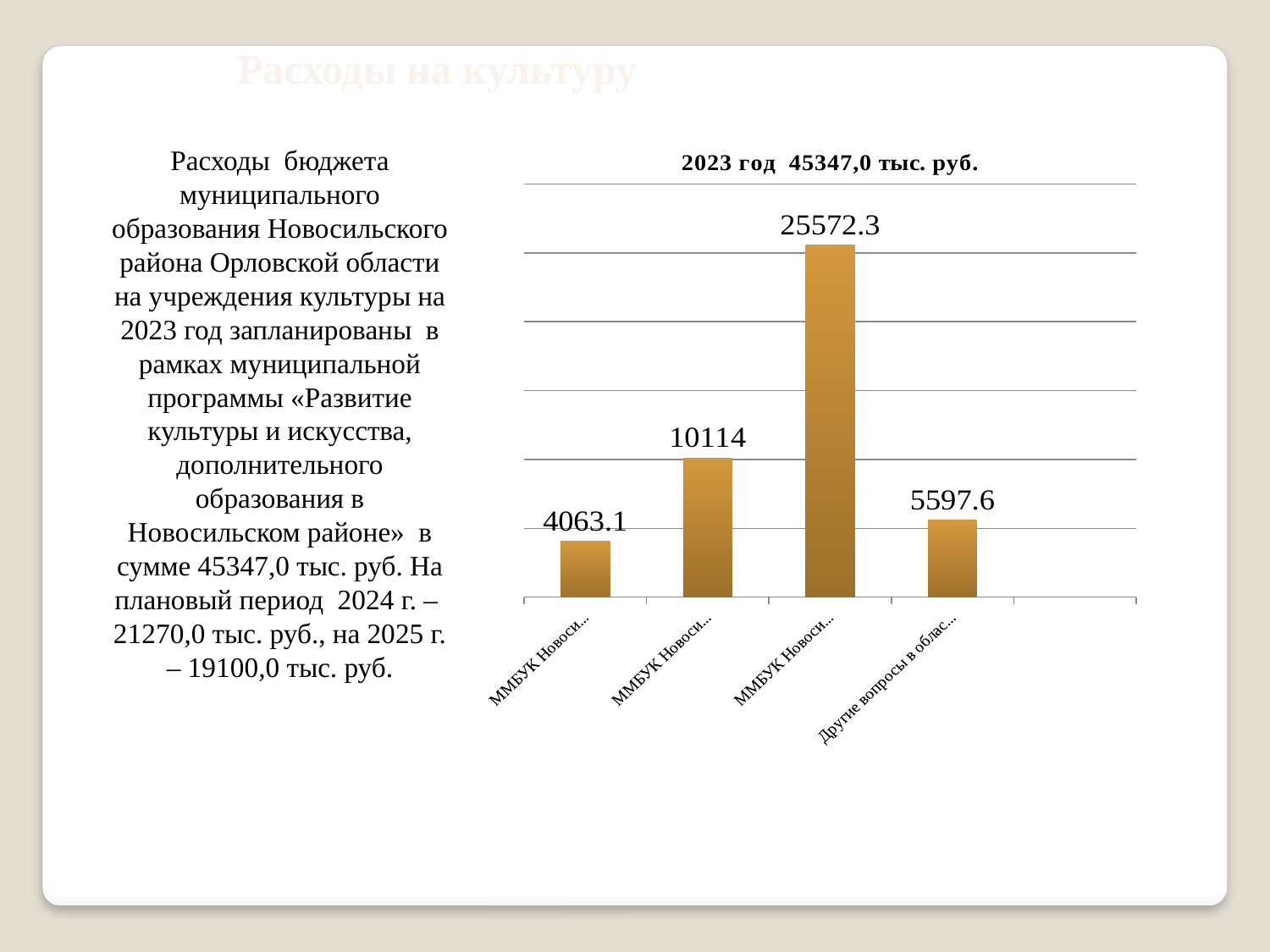
What is the value of the second bar from the left? 10114 What type of chart is shown on the slide? bar chart What is the lowest value shown in the chart? 4063.1 What is the difference between the rightmost bar (5597.6) and the leftmost bar (4063.1)? 1534.5 What is the value of the first (leftmost) bar? 4063.1 How many bars are plotted in the chart? 4 What is the highest value shown in the chart? 25572.3 What is the value of the third bar from the left? 25572.3 What is the title of the chart? 2023 год 45347,0 тыс. руб. What is the difference between the third bar (25572.3) and the second bar (10114)? 15458.3 Which is larger: the second bar from the left or the rightmost bar? the second bar (10114) What is the value of the bar for the category starting with "Другие вопросы"? 5597.6